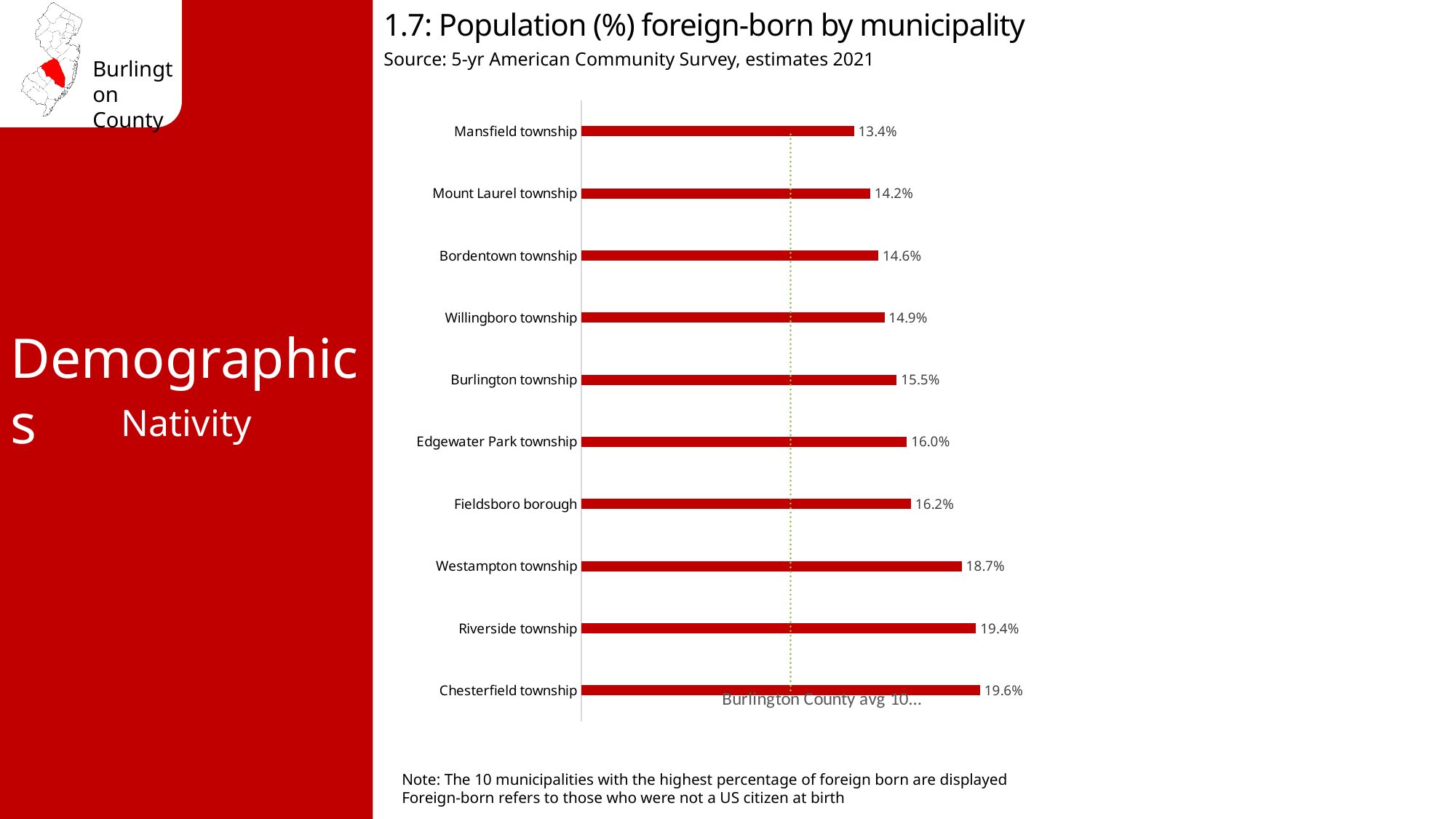
Which municipality has the lowest percentage of foreign-born population? Mansfield township Which has a higher foreign-born percentage, Burlington township or Willingboro township? Burlington township Which has a higher foreign-born percentage, Fieldsboro borough or Bordentown township? Fieldsboro borough What is the percentage of foreign-born population for Chesterfield township? 19.6% What is the percentage of foreign-born population for Edgewater Park township? 16.0% What is the percentage of foreign-born population for Mount Laurel township? 14.2% What is the difference in foreign-born percentage between Riverside township and Westampton township? 0.7% What is the source of the data shown in the chart? 5-yr American Community Survey, estimates 2021 How many municipalities are shown in the chart? 10 What is the difference in foreign-born percentage between Chesterfield township and Mansfield township? 6.2% What type of chart is used to show the foreign-born population by municipality? Bar chart Which municipality has the highest percentage of foreign-born population? Chesterfield township